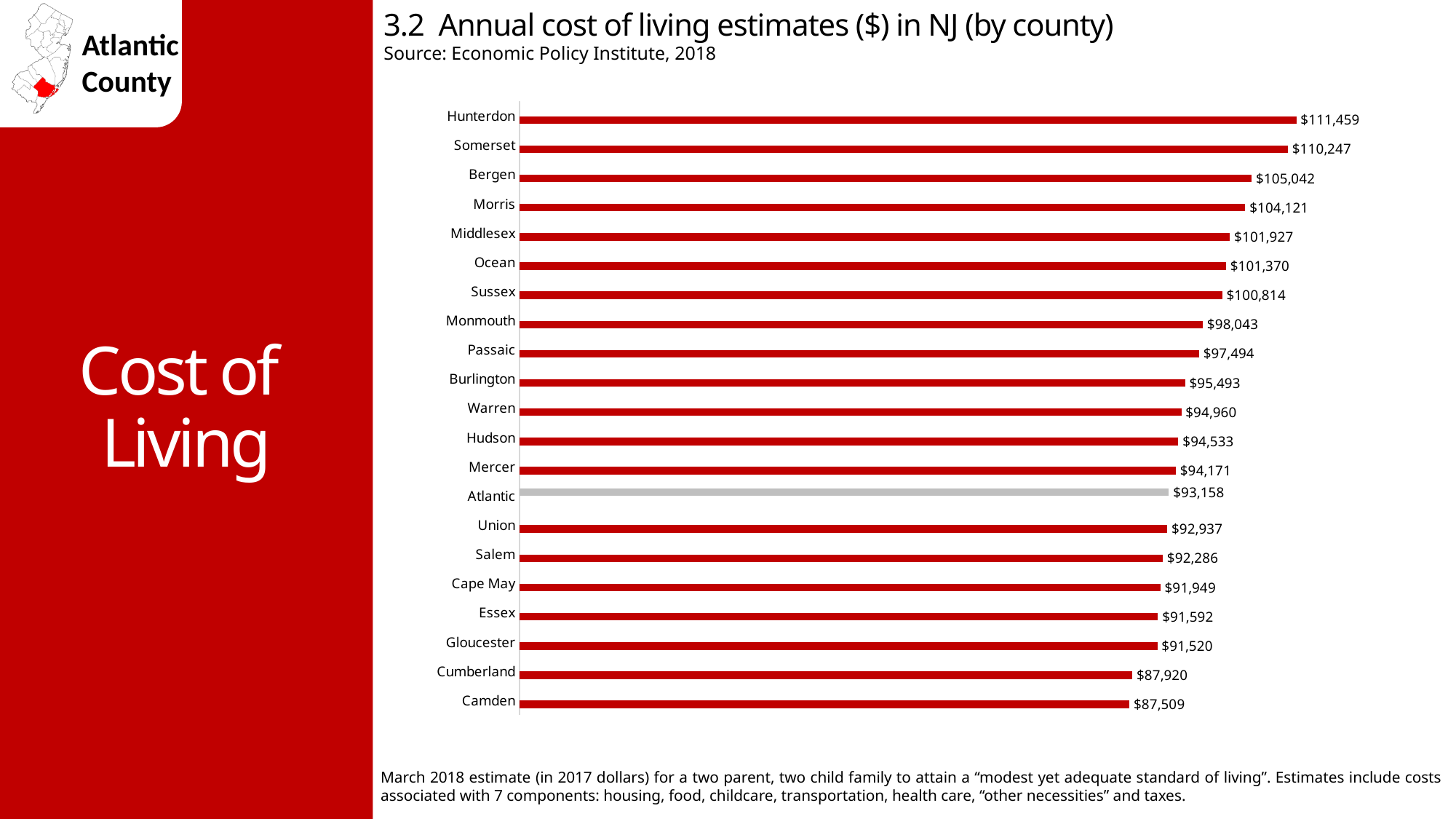
What is the annual cost of living estimate for Atlantic County? $93,158 Which county's bar is shown in grey rather than red? Atlantic What type of chart is used to show the cost of living estimates? Bar chart What is the annual cost of living estimate for Cape May County? $91,949 Which county has a higher cost of living estimate, Cumberland or Gloucester? Gloucester What is the difference between the cost of living estimates for Atlantic and Union counties? $221 What is the difference between the cost of living estimates for Hunterdon and Camden counties? $23,950 How many counties are shown in the chart? 21 Which county has a higher cost of living estimate, Bergen or Morris? Bergen What is the annual cost of living estimate for Hunterdon County? $111,459 Which county has the lowest annual cost of living estimate? Camden Which county has the highest annual cost of living estimate? Hunterdon